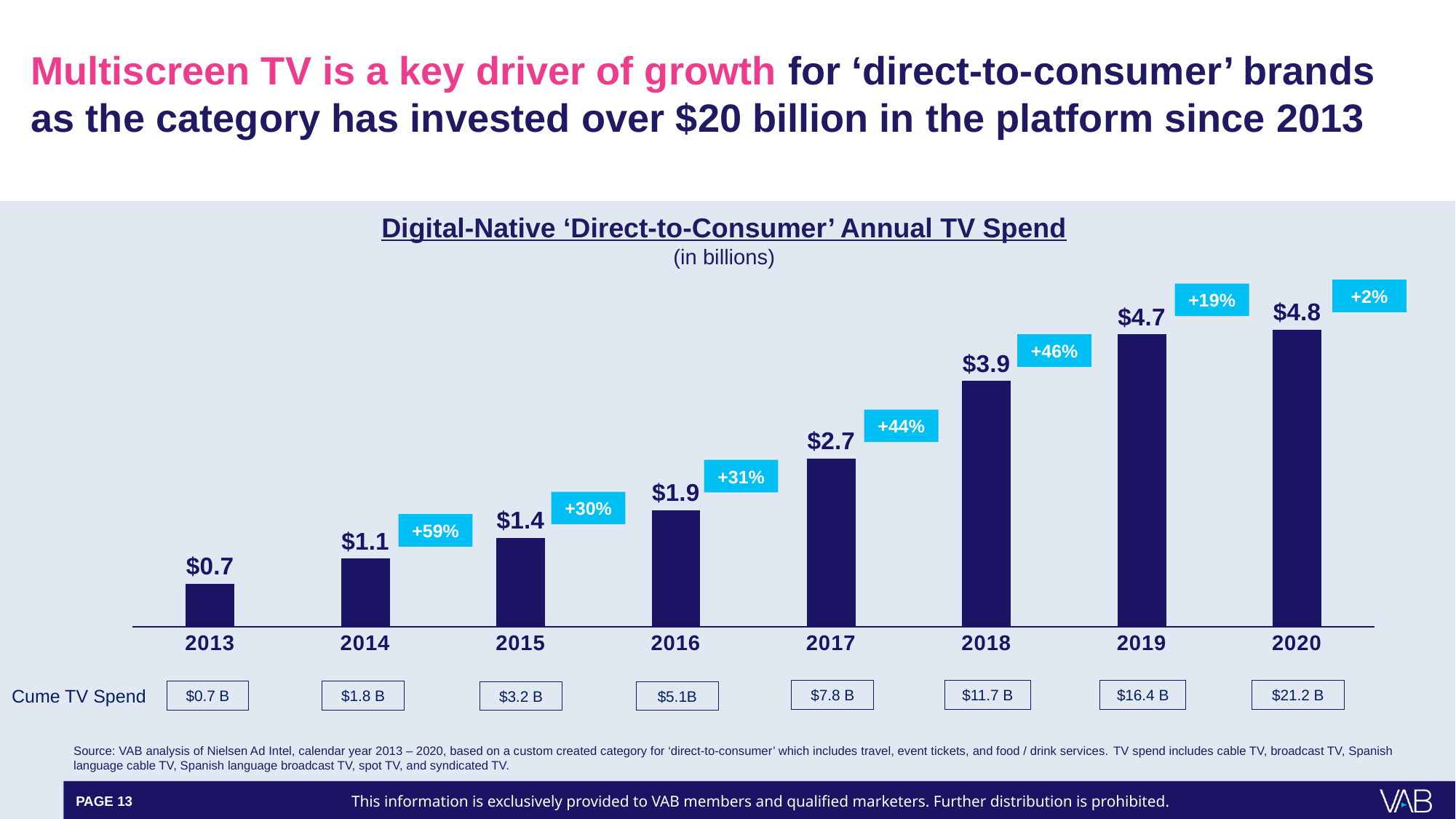
What is the cumulative TV spend shown for 2020? $21.2 B Do the annual TV spend values rise or fall from 2013 to 2020? Rise Which year has the lowest annual TV spend? 2013 What is the year-over-year growth percentage shown for 2018? +46% What is the annual TV spend for 2013? $0.7 What is the title of the chart? Digital-Native 'Direct-to-Consumer' Annual TV Spend What kind of chart is shown on the slide? Bar chart What is the difference in annual TV spend between 2019 and 2016? $2.8 Which year has a larger annual TV spend, 2015 or 2018? 2018 How many years are shown on the chart? 8 What is the annual TV spend for 2017? $2.7 Which year has the highest annual TV spend? 2020